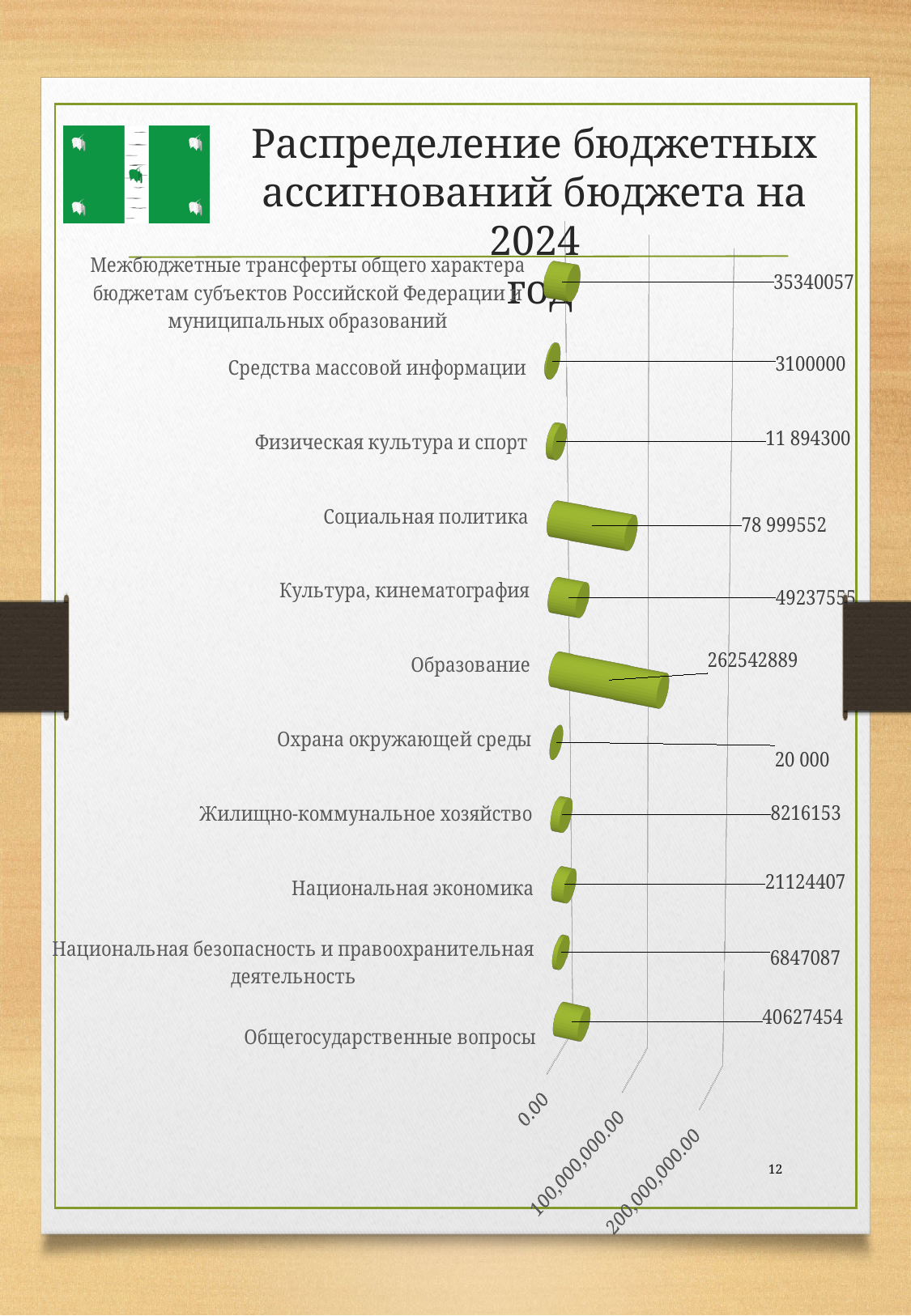
What kind of chart is shown on the slide? bar chart How many categories are shown in the chart? 11 What is the difference between the values for Национальная экономика and Жилищно-коммунальное хозяйство? 12908254 What value is shown for Социальная политика? 78 999552 Which category has the lowest value? Охрана окружающей среды What value is shown for Образование? 262542889 What value is shown for Общегосударственные вопросы? 40627454 What is the title of the slide? Распределение бюджетных ассигнований бюджета на 2024 год Which category has the highest value? Образование Which is larger: the value for Культура, кинематография or the value for Общегосударственные вопросы? Культура, кинематография What value is shown for Средства массовой информации? 3100000